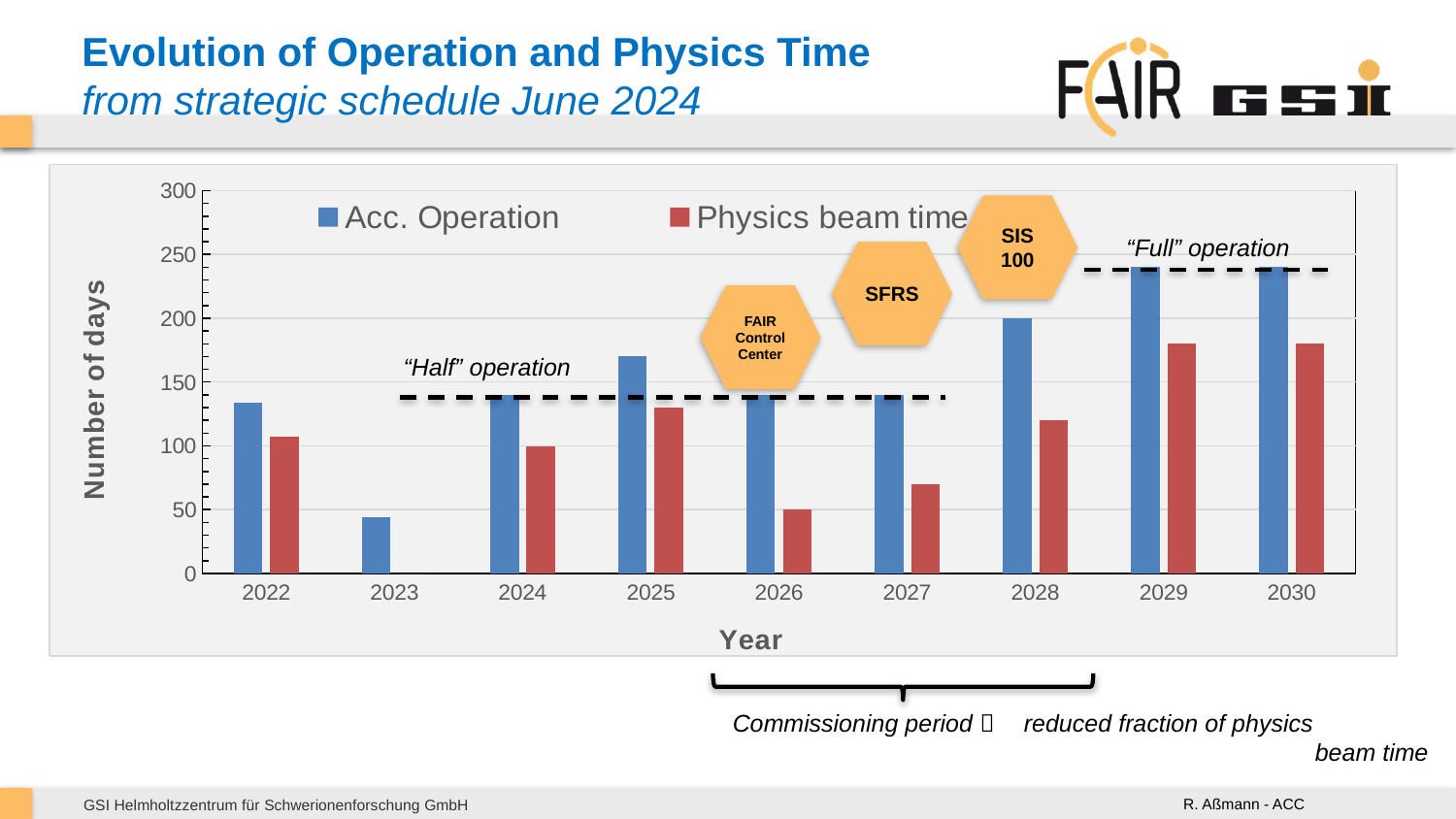
Is the Physics beam time value for 2027 greater or less than 100? less Which year has the lowest Acc. Operation value? 2023 Which is larger, the Physics beam time value for 2026 or for 2027? 2027 Do the Acc. Operation values rise or fall from 2027 to 2030? rise How many years are shown on the x axis of the chart? 9 Is the Acc. Operation value for 2029 greater or less than 200? greater Which is larger, the Acc. Operation value for 2025 or for 2024? 2025 How many series does the chart legend list? 2 What is the label of the y axis of the chart? Number of days What kind of chart is shown on the slide? bar chart Is the Acc. Operation value for 2023 greater or less than 50? less